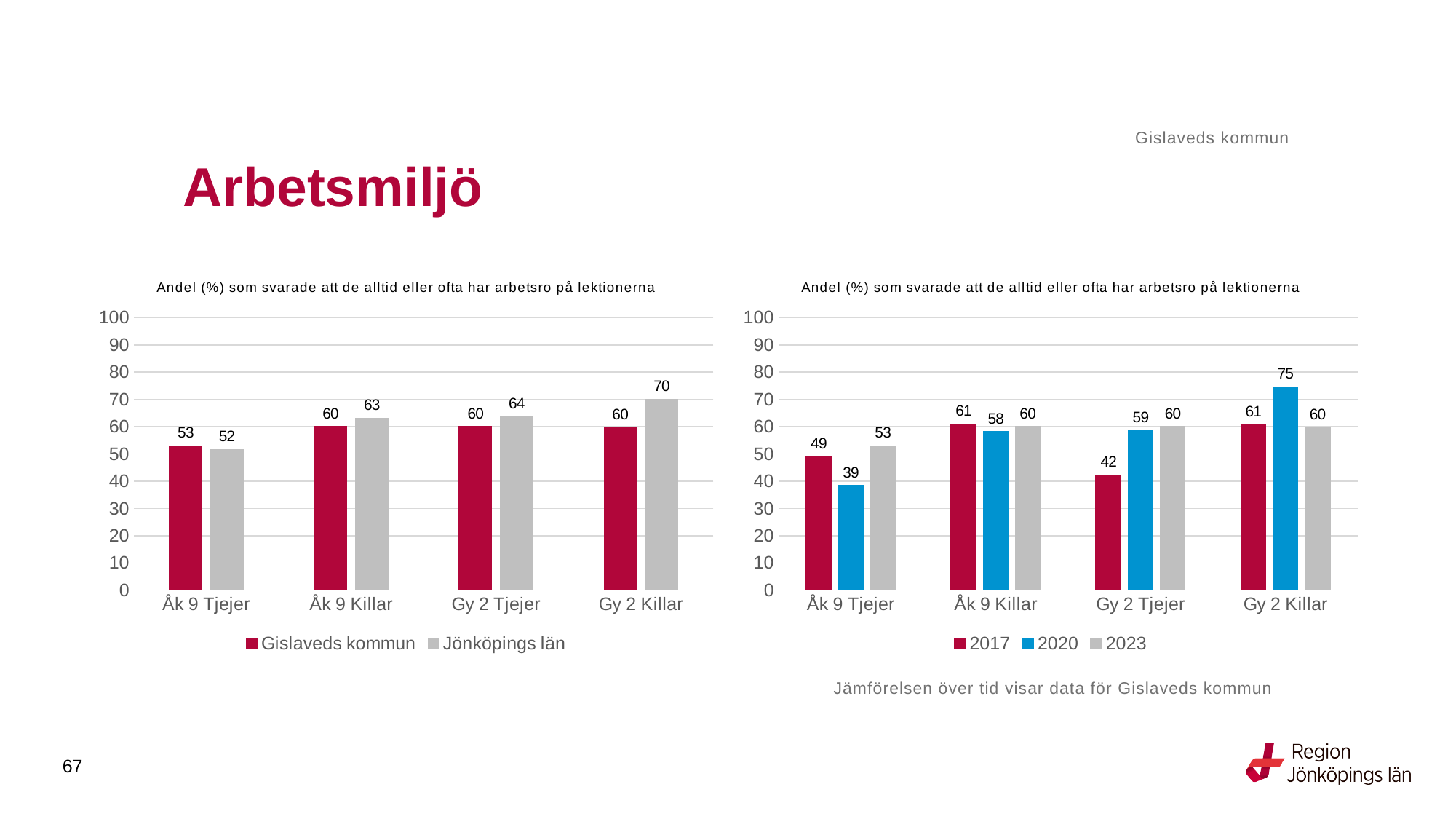
In the left chart, how many series does the legend list? 2 In the right chart, which category has the highest value for 2020? Gy 2 Killar In the right chart, is the value for 2017 for Åk 9 Tjejer larger or the value for 2023 for Åk 9 Tjejer? 2023 In the right chart, what is the value for 2017 for Gy 2 Tjejer? 42 In the right chart, which category has the lowest value for 2017? Gy 2 Tjejer In the right chart, how many categories are shown on the x axis? 4 What kind of chart is the right chart? Bar chart In the right chart, what is the value for 2020 for Åk 9 Tjejer? 39 In the left chart, what is the value for Jönköpings län for Gy 2 Killar? 70 In the left chart, what is the difference between Jönköpings län and Gislaveds kommun for Gy 2 Killar? 10 In the left chart, what is the value for Gislaveds kommun for Åk 9 Tjejer? 53 In the left chart, which category has the highest value for Jönköpings län? Gy 2 Killar